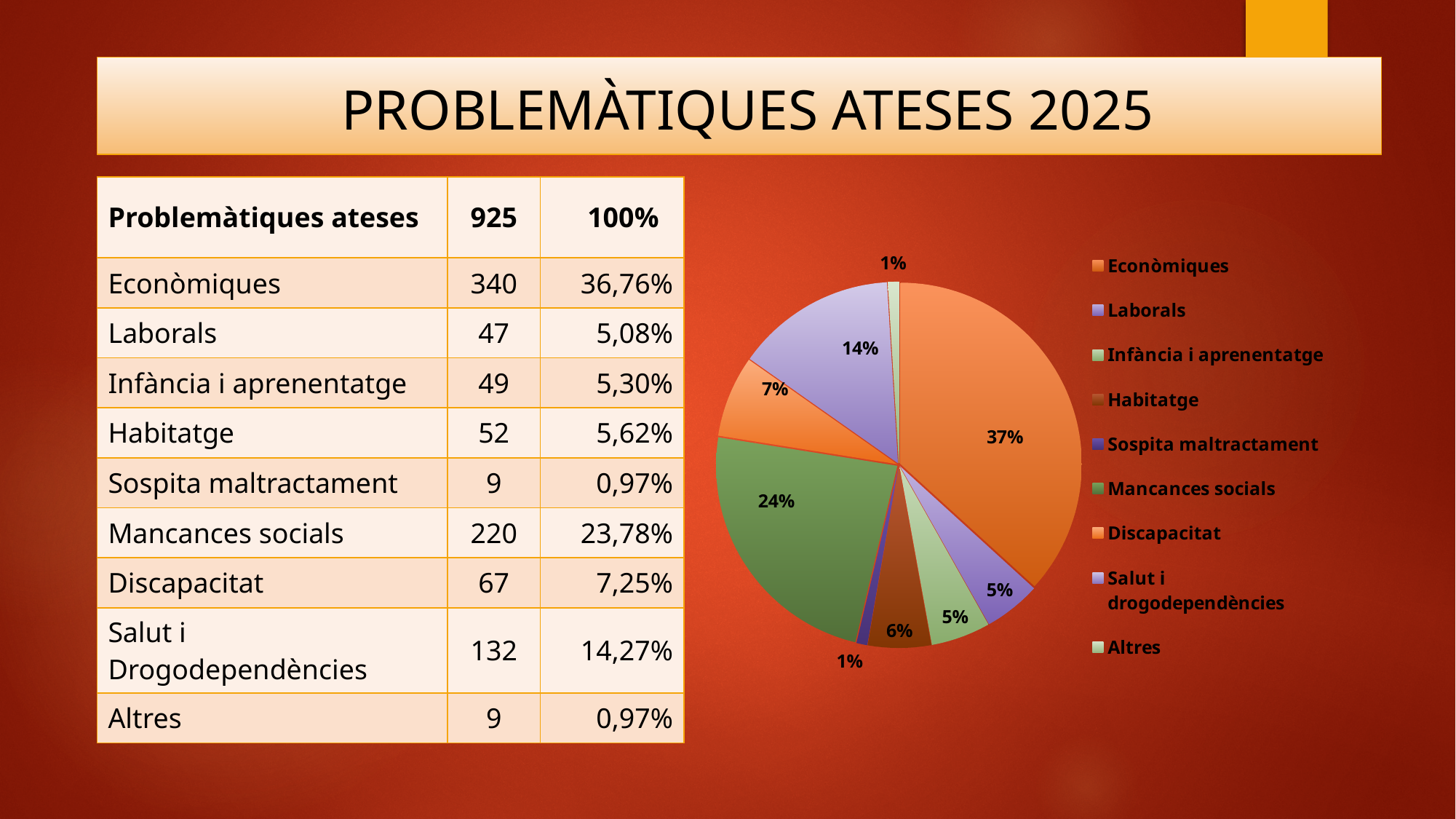
What is the difference in percentage points between the Econòmiques slice and the Mancances socials slice? 13% How many slices does the pie chart have? 9 Which is larger in the pie chart, Mancances socials or Salut i drogodependències? Mancances socials What share of the pie does Discapacitat represent? 7% What share of the pie does Habitatge represent? 6% How many entries does the pie chart's legend list? 9 What colour is the Mancances socials slice in the pie chart? Green What share of the pie does Mancances socials represent? 24% What kind of chart is shown on the slide? Pie chart Which category has the largest slice of the pie chart? Econòmiques